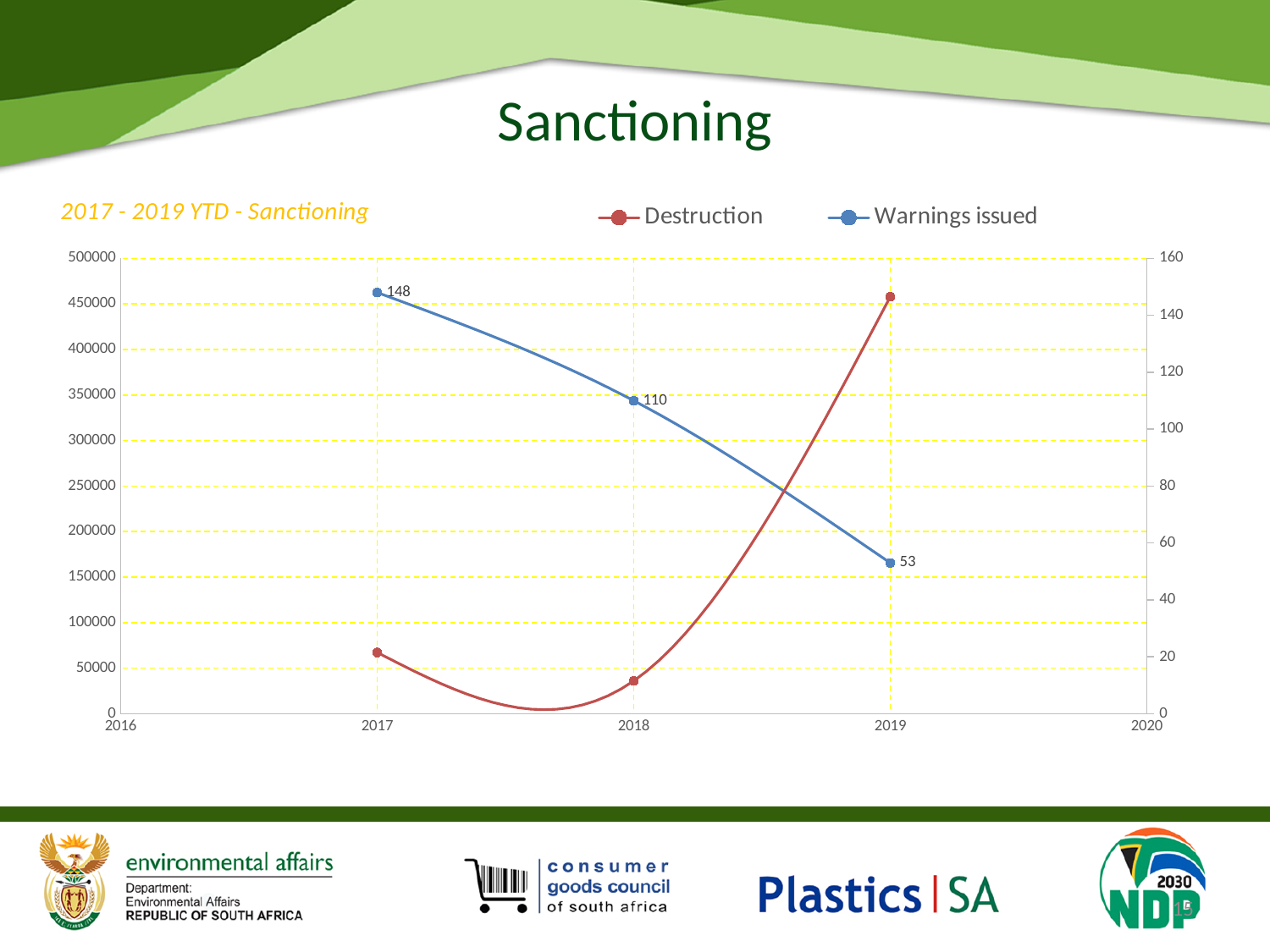
What kind of chart is shown on the slide? line chart Do the Warnings issued values rise or fall from 2017 to 2019? fall In which year was the number of Warnings issued lowest? 2019 What is the difference between Warnings issued in 2017 and in 2019? 95 Is the Destruction value for 2018 greater or less than 50000? less In which year was the number of Warnings issued highest? 2017 Is the Destruction value for 2019 greater or less than 400000? greater What is the value for Warnings issued in 2019? 53 What is the value for Warnings issued in 2018? 110 How many series does the legend list? 2 What is the value for Warnings issued in 2017? 148 In which year is the Destruction value highest? 2019